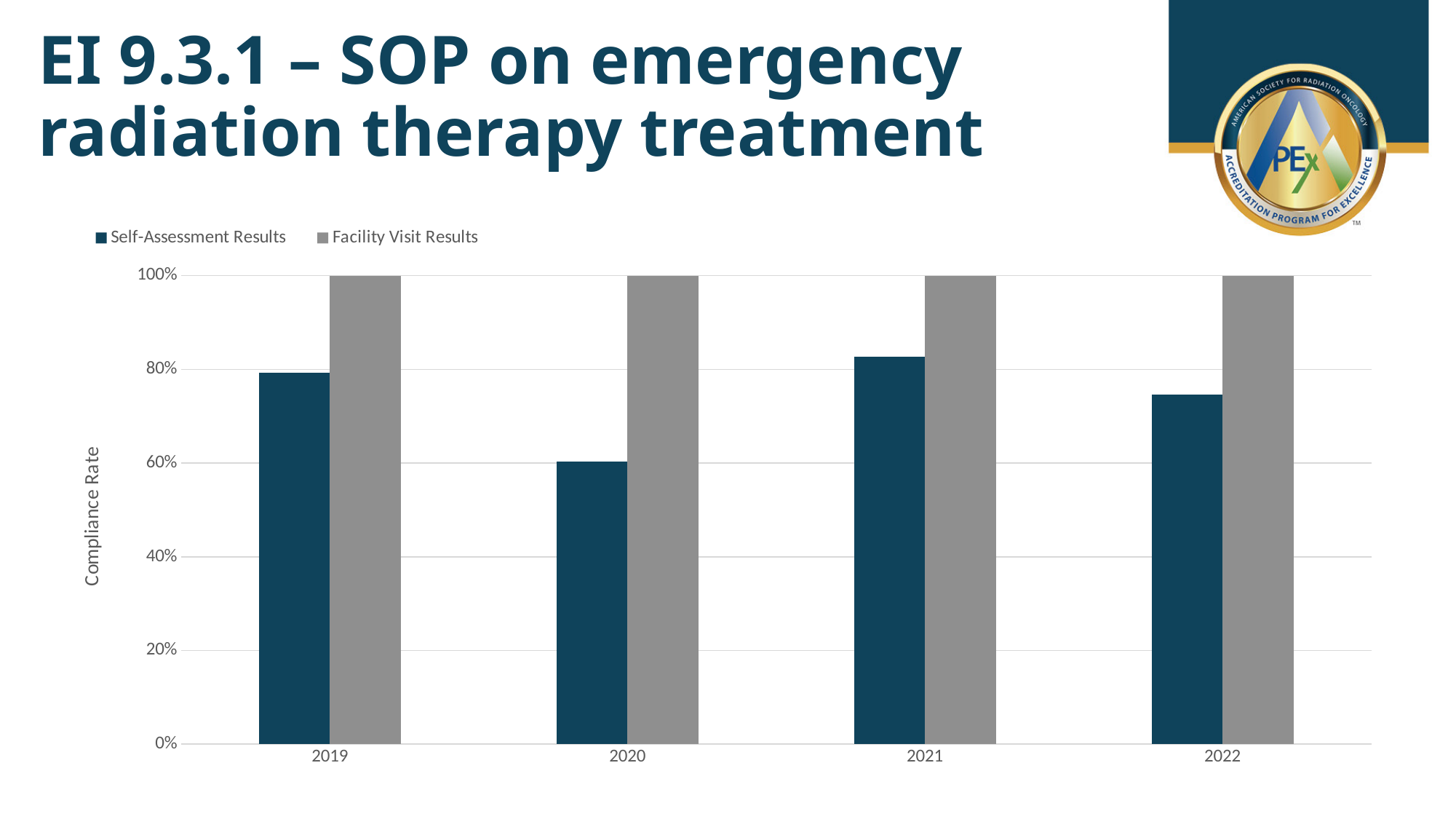
Is the Self-Assessment Results value for 2022 greater or less than 80%? less How many years are shown on the x axis? 4 What is the Facility Visit Results value for 2022? 100% What is the Facility Visit Results value for 2019? 100% Which year has the larger Self-Assessment Results value, 2019 or 2020? 2019 Is the Self-Assessment Results value for 2021 greater or less than 80%? greater Which year has the lowest Self-Assessment Results value? 2020 Which year has the highest Self-Assessment Results value? 2021 What is the label on the y axis? Compliance Rate Which is larger in 2019, the Self-Assessment Results value or the Facility Visit Results value? Facility Visit Results What kind of chart is shown on the slide? bar chart How many series does the legend list? 2